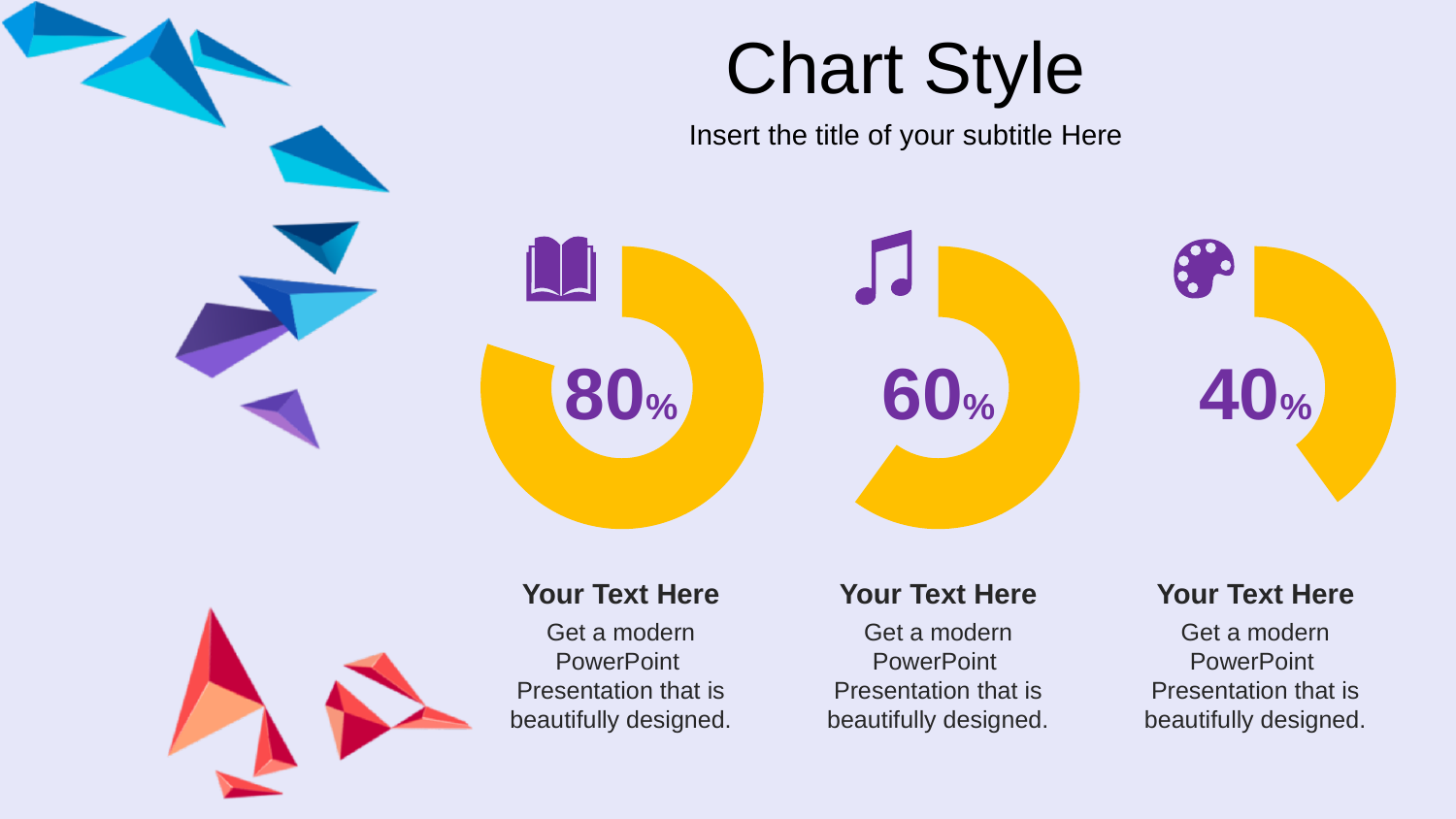
Which of the three donut charts shows the highest percentage? The left-hand chart (80%) What percentage is shown in the middle donut chart? 60% Do the percentages rise or fall when reading the donut charts from left to right? Fall What percentage is shown in the right-hand donut chart? 40% What kind of chart is used to display the percentages on this slide? Donut chart Which of the three donut charts shows the lowest percentage? The right-hand chart (40%) How many donut charts are shown on the slide? 3 What percentage is shown in the left-hand donut chart? 80% What is the difference between the percentage in the left-hand donut chart and the percentage in the right-hand donut chart? 40% What colour is the filled ring in each donut chart? Yellow Which is larger, the percentage in the middle donut chart or the percentage in the right-hand donut chart? The middle chart (60%) What is the difference between the percentage in the middle donut chart and the percentage in the right-hand donut chart? 20%